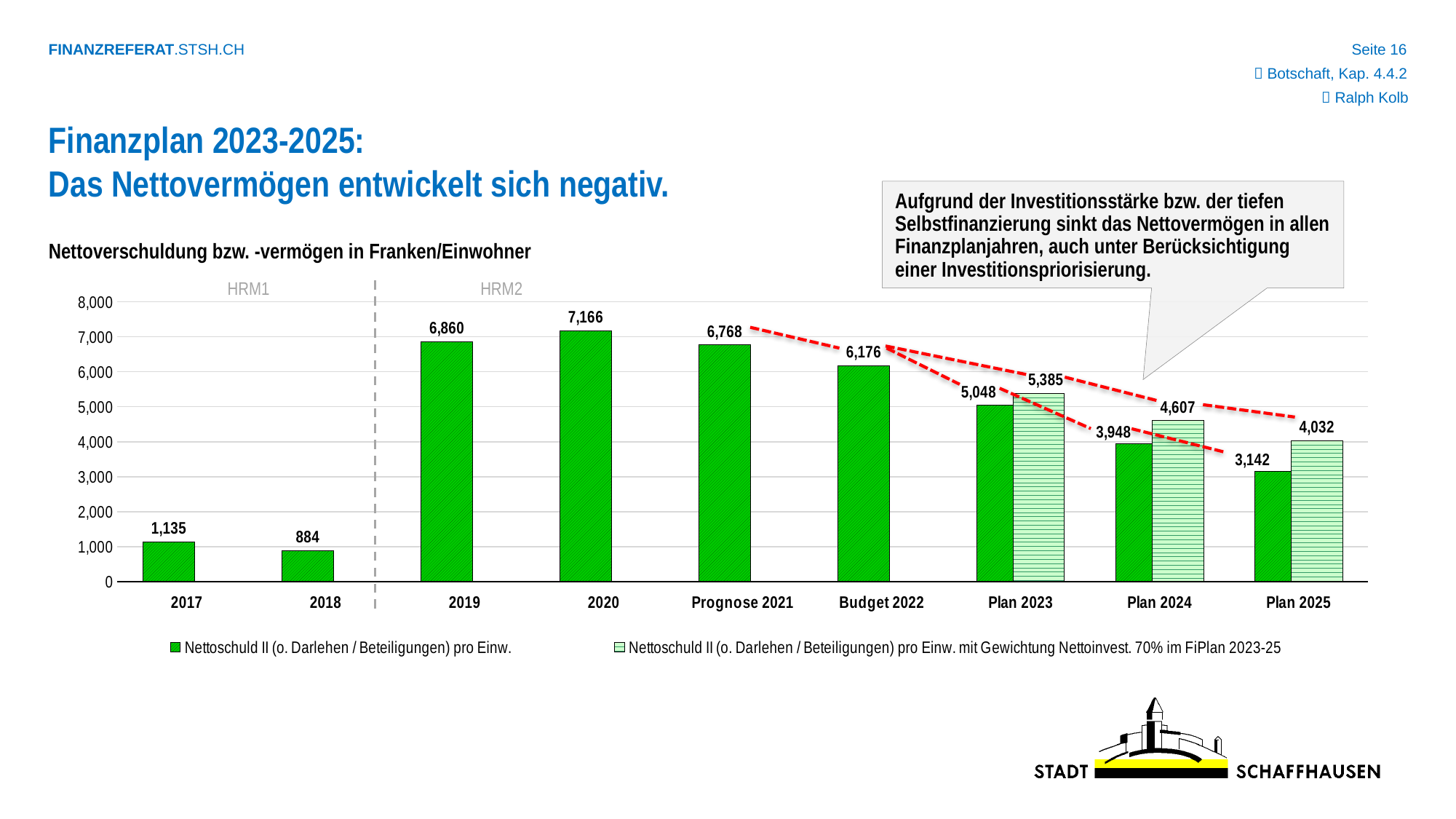
What is the value of the series with Gewichtung Nettoinvest. 70% for Plan 2024? 4,607 What kind of chart is shown on the slide? Bar chart What is the difference between the Nettoschuld II pro Einw. values for 2020 and Plan 2025? 4,024 How many categories are shown on the x axis? 9 What is the difference between the two series' values for Plan 2025? 890 Which category has the highest value for Nettoschuld II (o. Darlehen / Beteiligungen) pro Einw.? 2020 How many series does the legend list? 2 Which is larger: the Nettoschuld II pro Einw. value for Prognose 2021 or for Budget 2022? Prognose 2021 What is the value of Nettoschuld II (o. Darlehen / Beteiligungen) pro Einw. for 2018? 884 What is the value of Nettoschuld II (o. Darlehen / Beteiligungen) pro Einw. for 2020? 7,166 From 2019 to Plan 2025, do the values of Nettoschuld II (o. Darlehen / Beteiligungen) pro Einw. generally rise or fall? Fall Which category has the lowest value for Nettoschuld II (o. Darlehen / Beteiligungen) pro Einw.? 2018